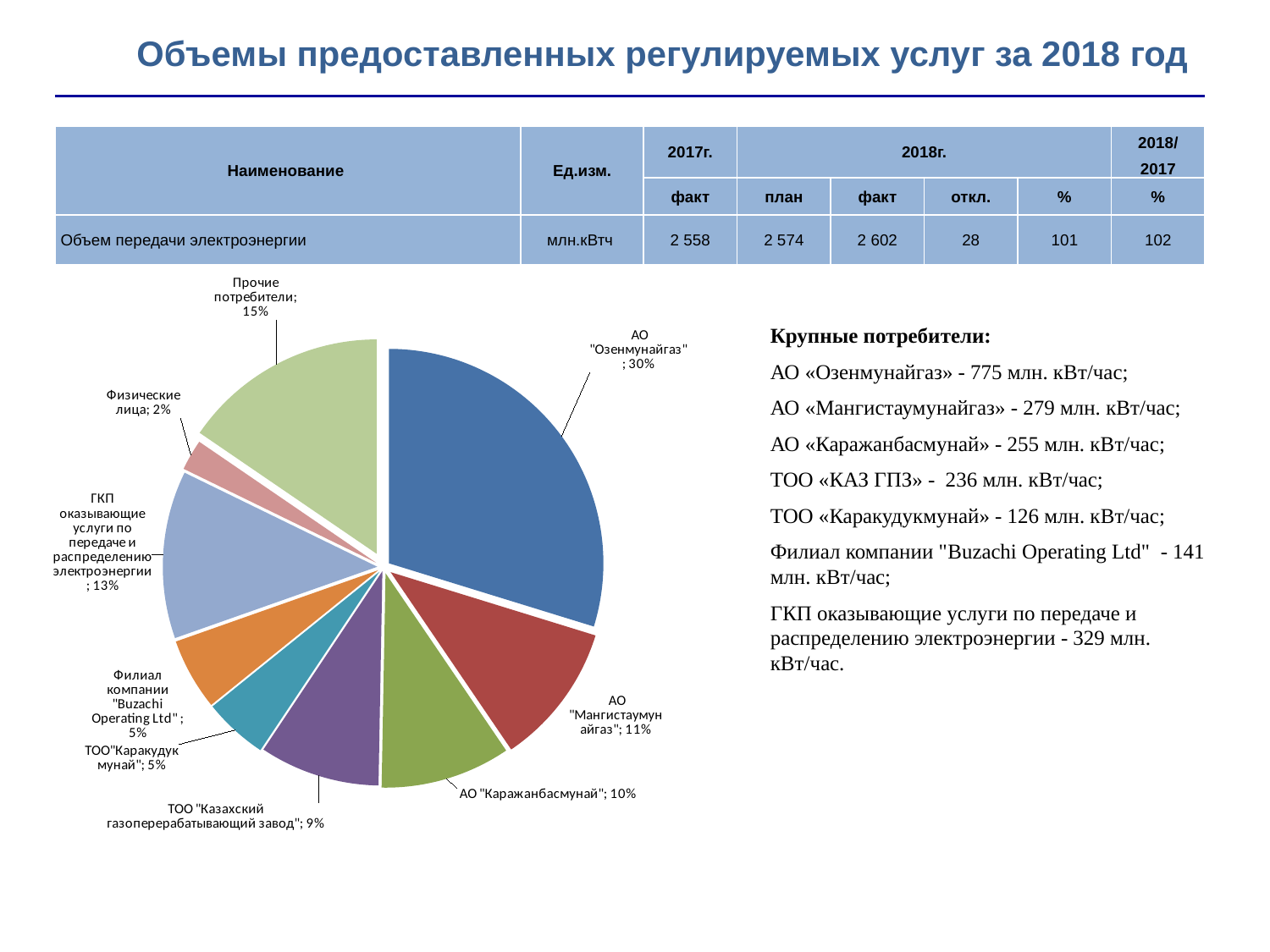
What share of the pie does АО "Озенмунайгаз" have? 30% Which category has the largest slice of the pie? АО "Озенмунайгаз" What is the difference in percentage points between the shares of АО "Озенмунайгаз" and Прочие потребители? 15 What share of the pie does АО "Каражанбасмунай" have? 10% What share of the pie does АО "Мангистаумунайгаз" have? 11% What kind of chart is shown on the slide? pie chart How many slices does the pie chart have? 9 Which category has the smallest slice of the pie? Физические лица Which has a larger share of the pie: ГКП оказывающие услуги по передаче и распределению электроэнергии or АО "Мангистаумунайгаз"? ГКП оказывающие услуги по передаче и распределению электроэнергии